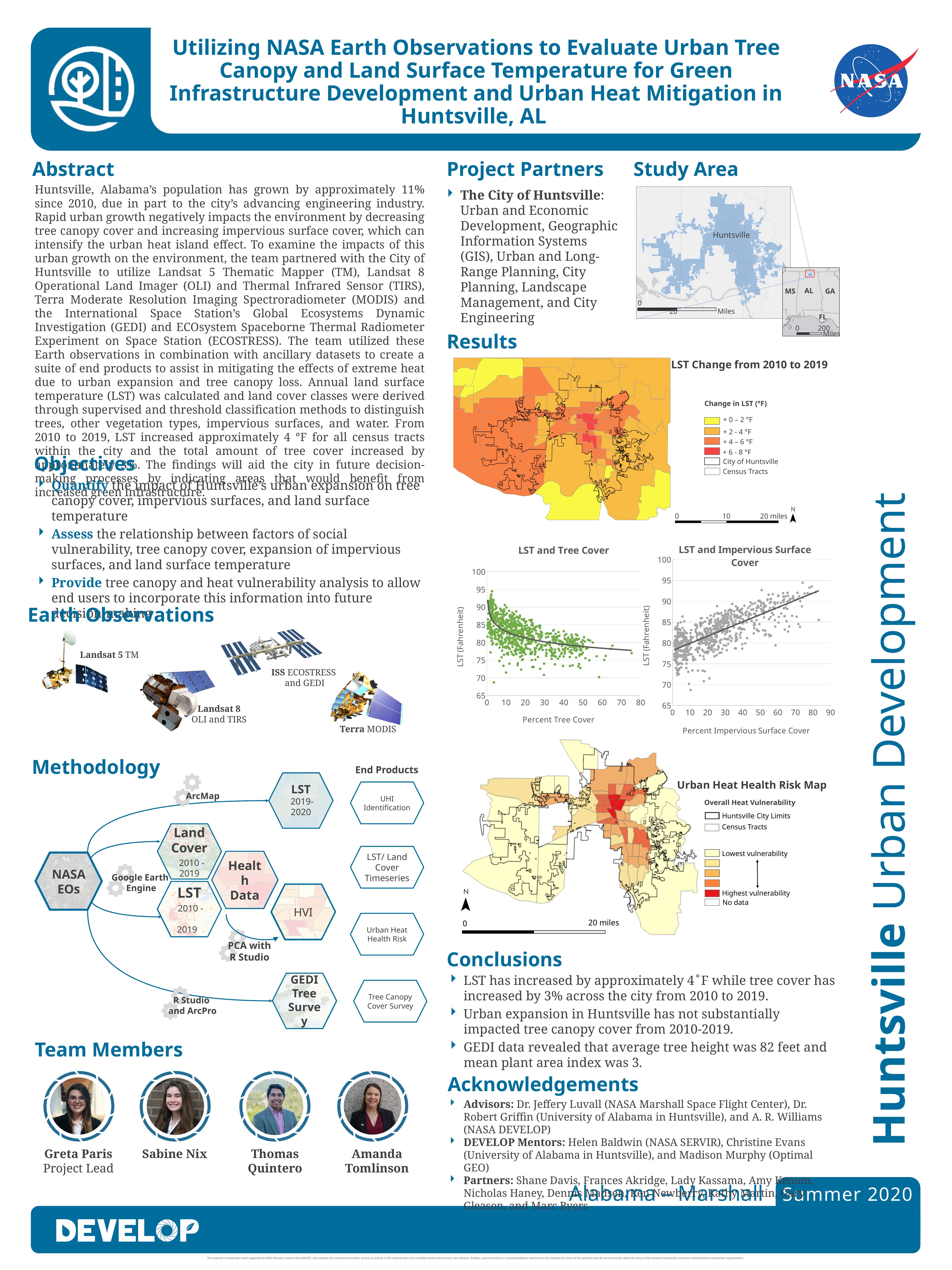
In the "LST and Tree Cover" chart, does LST rise or fall as percent tree cover increases? fall What kind of chart is the "LST and Tree Cover" chart? scatter chart What kind of chart is the "LST and Impervious Surface Cover" chart? scatter chart What is the y-axis title of the "LST and Impervious Surface Cover" chart? LST (Fahrenheit) In the "LST and Impervious Surface Cover" chart, does LST rise or fall as percent impervious surface cover increases? rise What is the x-axis title of the "LST and Tree Cover" chart? Percent Tree Cover In the "LST and Tree Cover" chart, what is the highest value shown on the y-axis? 100 In the "LST and Impervious Surface Cover" chart, what is the highest value shown on the x-axis? 90 In the "LST and Impervious Surface Cover" chart, what is the lowest value shown on the y-axis? 65 In the "LST and Tree Cover" chart, what is the highest value shown on the x-axis? 80